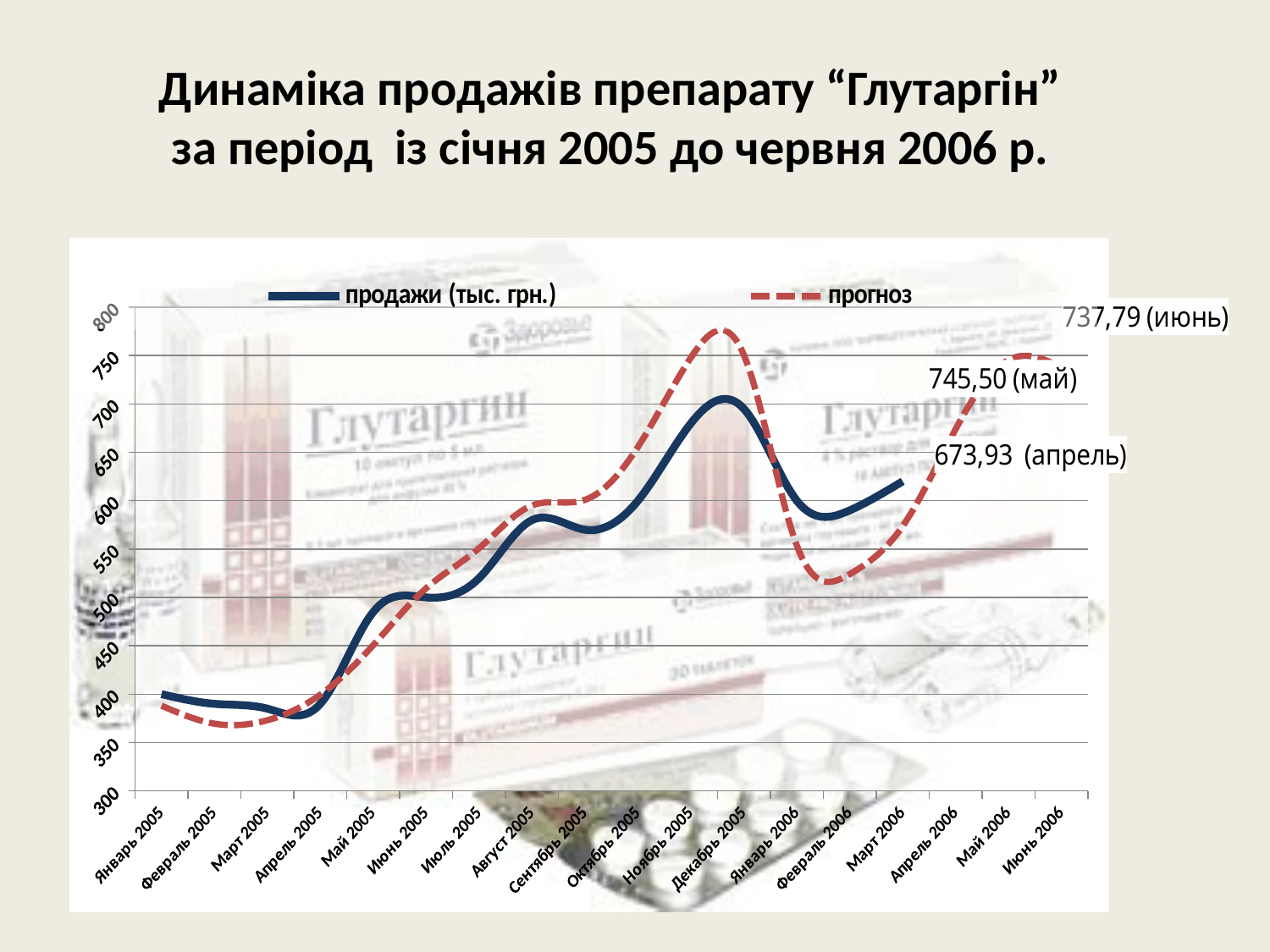
What is the forecast (прогноз) value labelled for июнь 2006? 737,79 What are the two series named in the legend? продажи (тыс. грн.) and прогноз Is the sales (продажи) value for Декабрь 2005 greater or less than 650? greater How many series does the legend list? 2 Which labelled forecast value is larger, май 2006 or июнь 2006? май 2006 What kind of chart is shown on the slide? line chart Do sales (продажи) rise or fall from Декабрь 2005 to Февраль 2006? fall How many months are shown along the x axis? 18 In which month does the sales (продажи) line reach its highest point? Декабрь 2005 What is the forecast (прогноз) value labelled for май 2006? 745,50 What is the forecast (прогноз) value labelled for апрель 2006? 673,93 What is the difference between the labelled forecast values for май 2006 and апрель 2006? 71,57